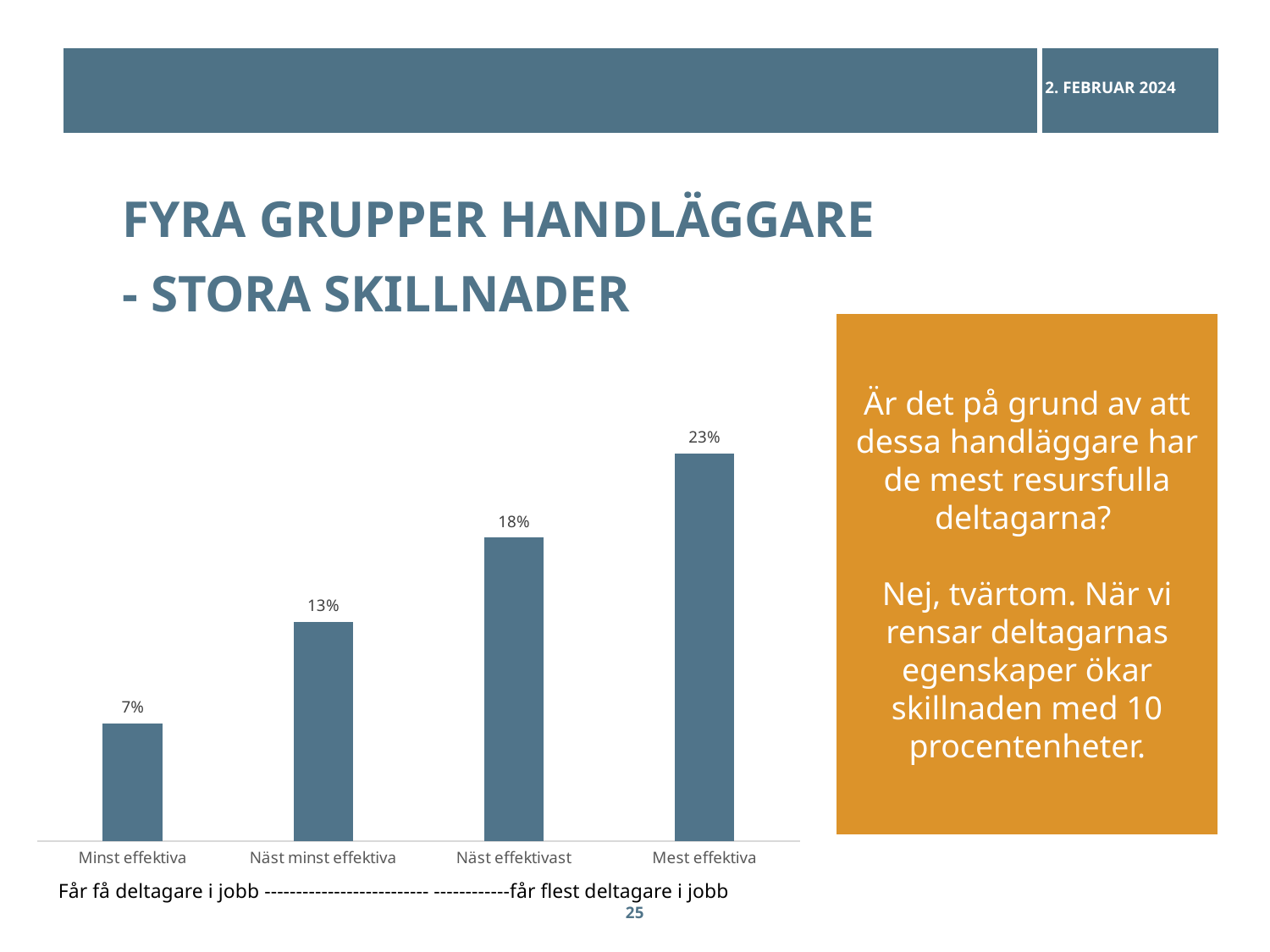
What is the value for Näst minst effektiva? 13% What is the value for Mest effektiva? 23% How many categories are shown in the chart? 4 What is the value for Minst effektiva? 7% Which category has the highest value? Mest effektiva What kind of chart is shown on the slide? Bar chart Which is larger, the value for Näst minst effektiva or the value for Näst effektivast? Näst effektivast What is the difference between the values for Mest effektiva and Minst effektiva? 16% What is the difference between the values for Näst effektivast and Näst minst effektiva? 5% What is the value for Näst effektivast? 18% Do the values rise or fall from left to right along the x axis? Rise Which category has the lowest value? Minst effektiva